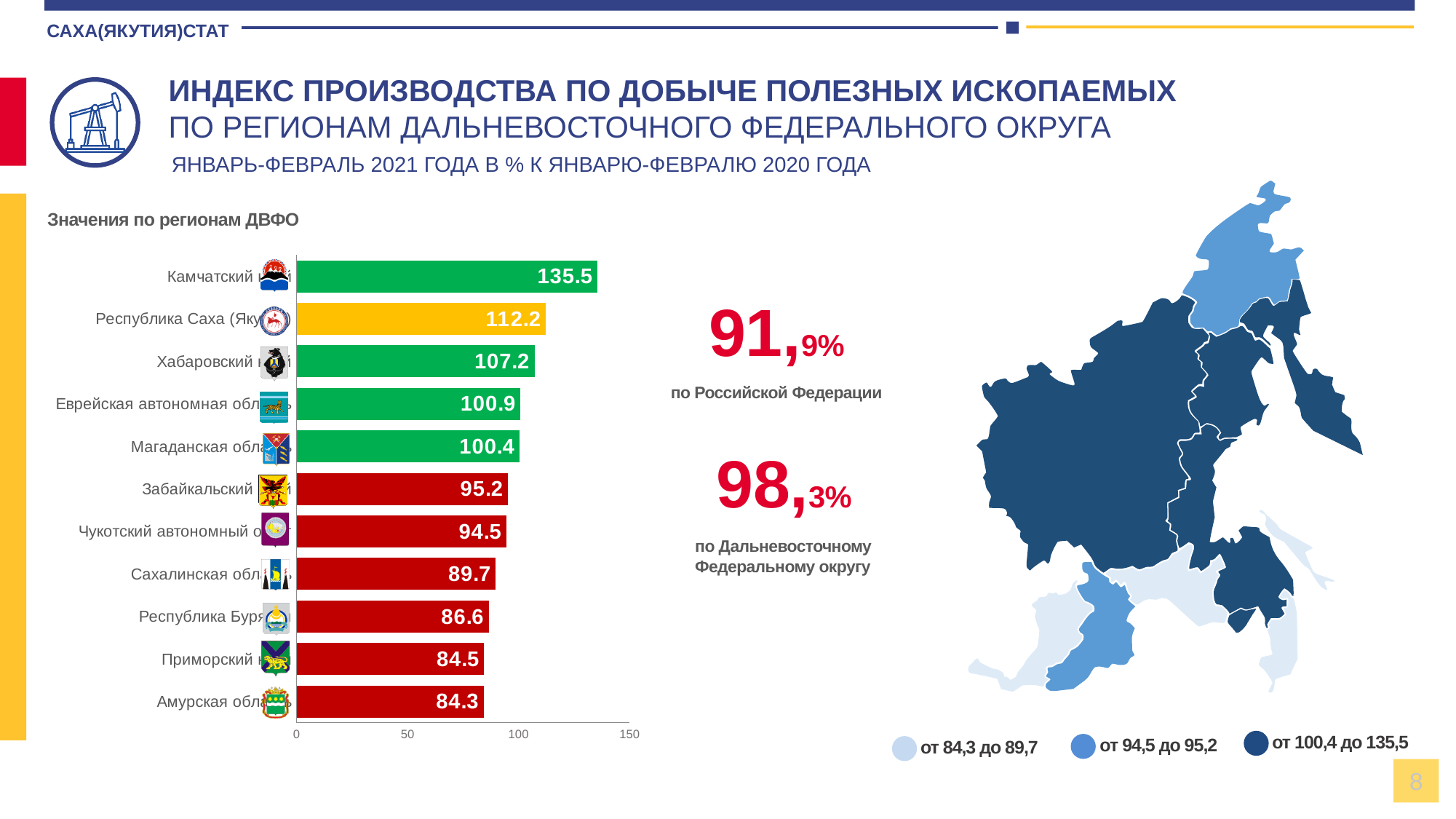
Is the value for Чукотский автономный округ greater or less than 100? less Which has a larger value, Хабаровский край or Забайкальский край? Хабаровский край What is the value for Сахалинская область in the bar chart? 89.7 What type of chart is used to show the values by region? bar chart What value is shown for the Russian Federation (по Российской Федерации) on the slide? 91,9% What is the difference between the values for Камчатский край and Республика Саха (Якутия)? 23.3 What is the value for Камчатский край in the bar chart? 135.5 What is the value for Республика Саха (Якутия) in the bar chart? 112.2 Which region has the lowest value in the bar chart? Амурская область Which region has the highest value in the bar chart? Камчатский край What is the value for Магаданская область in the bar chart? 100.4 How many regions are shown in the bar chart? 11